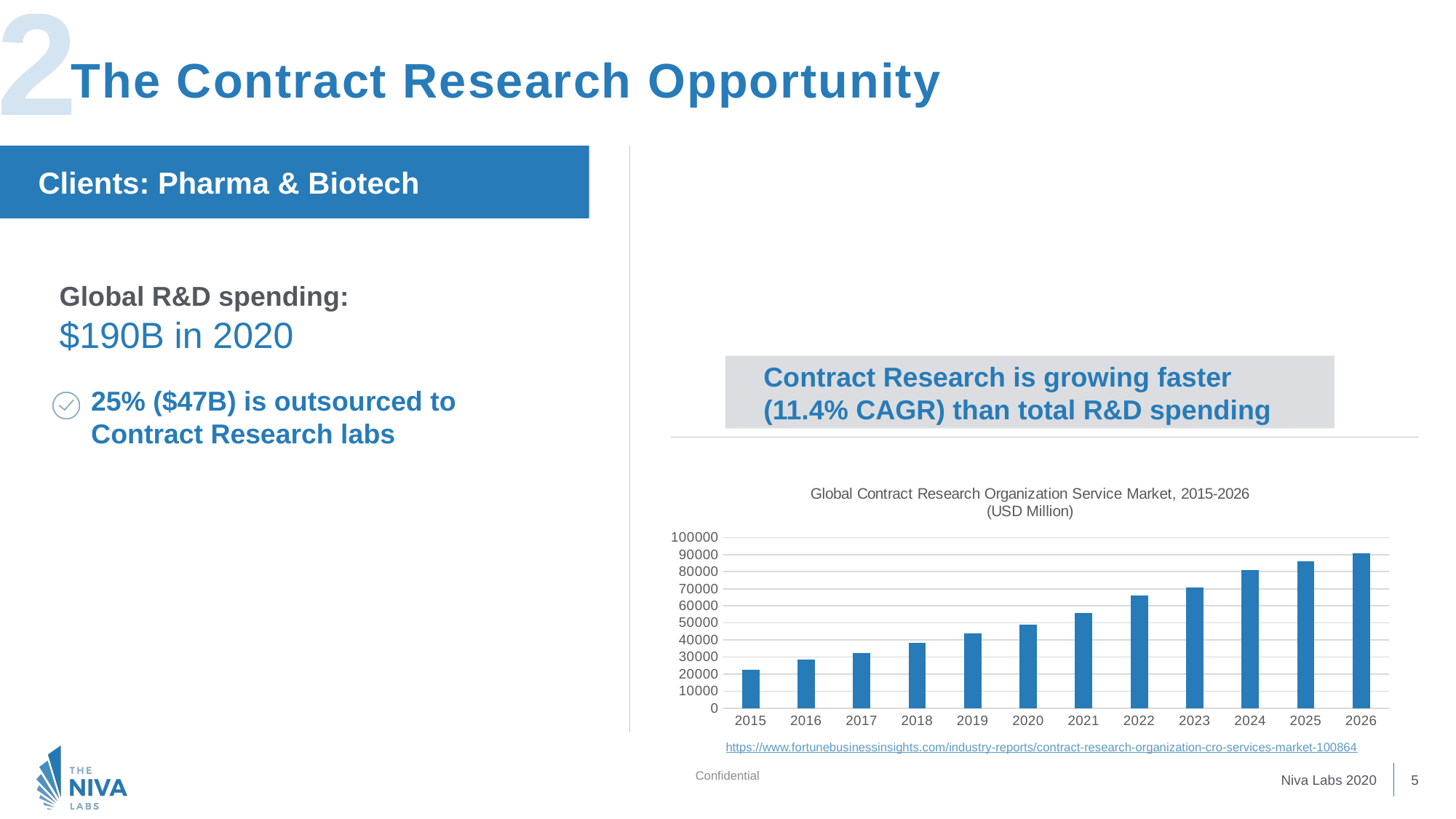
Which year has the highest value in the chart? 2026 How many years are shown on the x axis of the chart? 12 Do the values in the chart rise or fall from 2015 to 2026? rise Is the value for 2024 greater or less than 70000? greater Is the value for 2026 greater or less than 80000? greater Is the value for 2015 greater or less than 30000? less Which year has the lowest value in the chart? 2015 What is the title of the chart? Global Contract Research Organization Service Market, 2015-2026 (USD Million) What kind of chart is shown on the slide? bar chart Which year has the larger value, 2019 or 2023? 2023